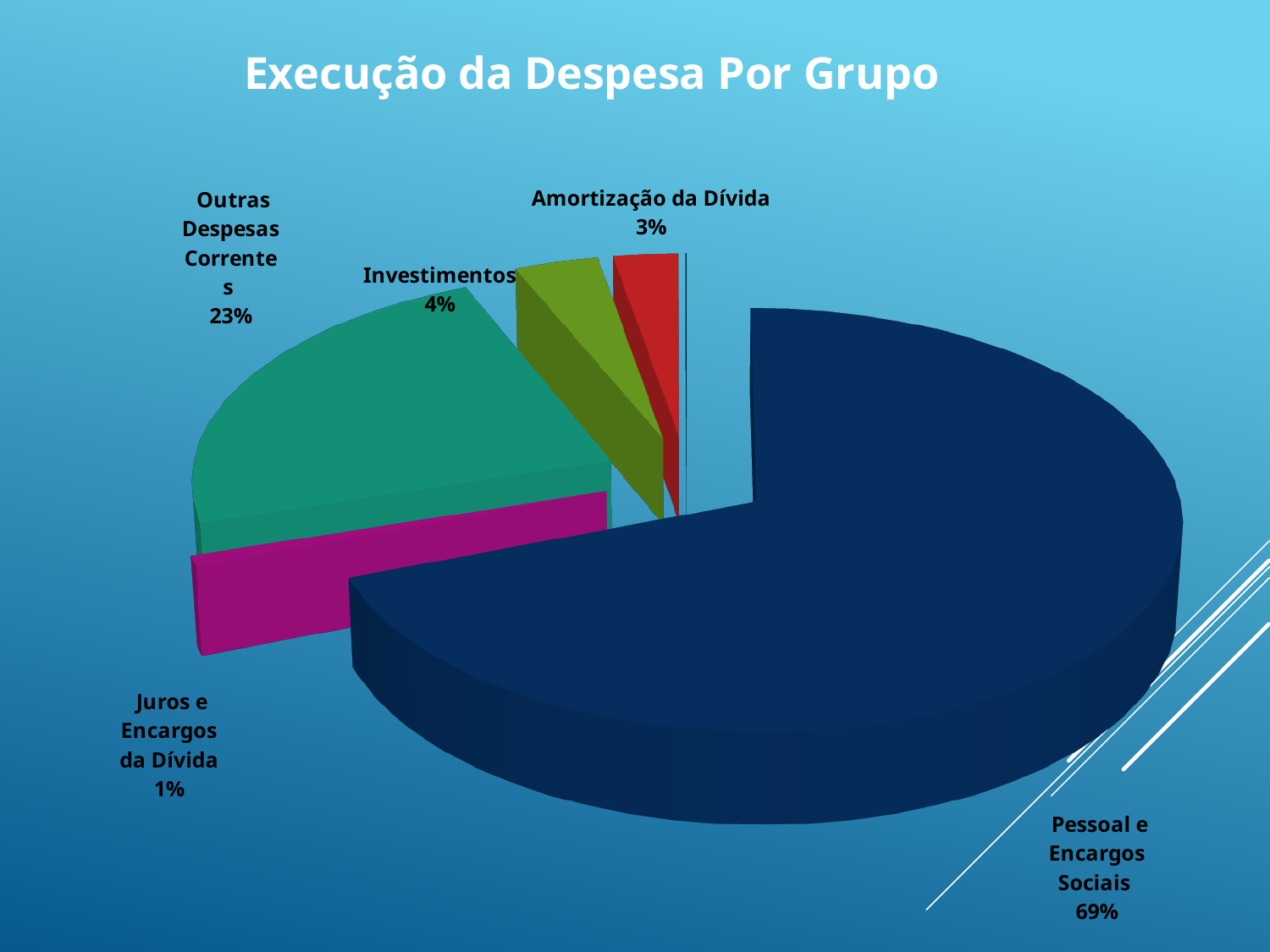
What is the difference in percentage points between Pessoal e Encargos Sociais and Outras Despesas Correntes? 46 What share of the pie does Pessoal e Encargos Sociais represent? 69% Which group has the largest share of the pie? Pessoal e Encargos Sociais What is the value shown for Investimentos? 4% Which is larger, Investimentos or Amortização da Dívida? Investimentos What is the title of the chart? Execução da Despesa Por Grupo What share of the pie does Outras Despesas Correntes represent? 23% What kind of chart is shown on the slide? Pie chart What is the value shown for Amortização da Dívida? 3% What is the value shown for Juros e Encargos da Dívida? 1%